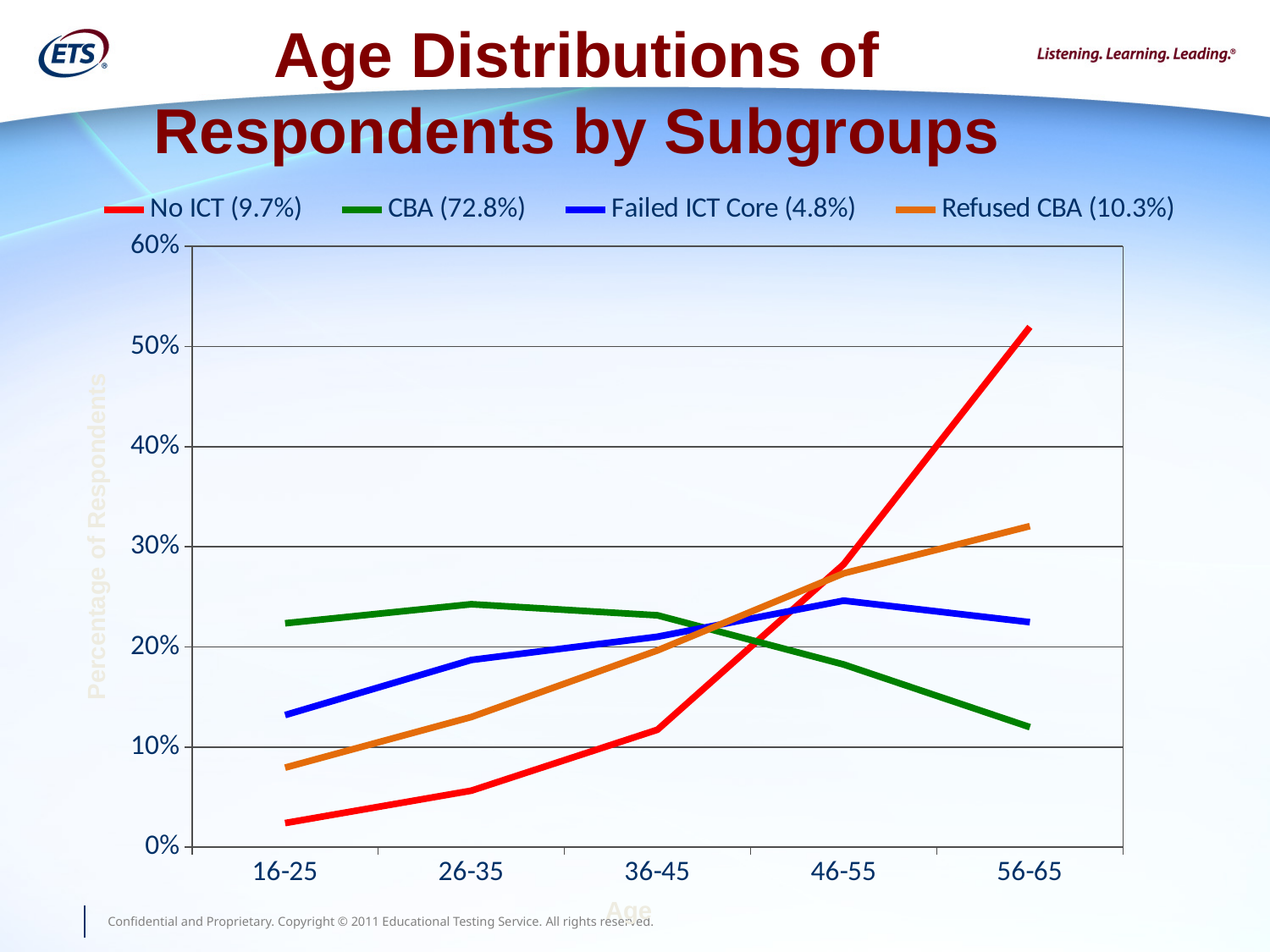
How many series does the legend list? 4 Does the No ICT line rise or fall as age increases from 16-25 to 56-65? rises Is the value for CBA at 56-65 greater or less than 20%? less Which series has the highest value for the 56-65 age group? No ICT (9.7%) Is the value for No ICT at 56-65 greater or less than 50%? greater What kind of chart is shown on the slide? line chart At 16-25, which is larger: the value for CBA or the value for Failed ICT Core? CBA Does the CBA line rise or fall from 36-45 to 56-65? falls Which series has the lowest value for the 16-25 age group? No ICT (9.7%) How many age groups are shown on the x axis? 5 Is the value for Refused CBA at 56-65 greater or less than 30%? greater What percentage is shown in the legend next to CBA? 72.8%